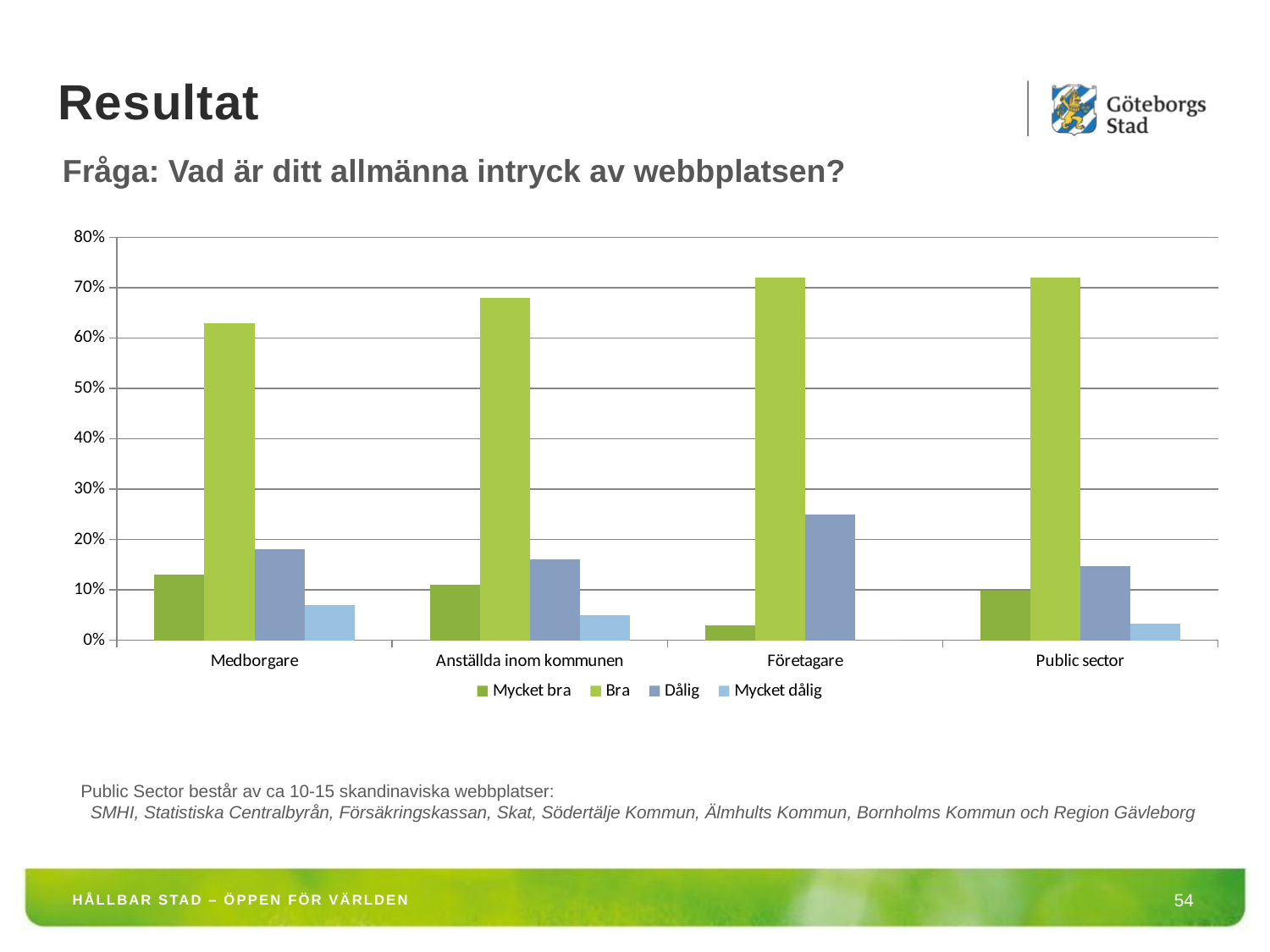
Is the value for Dålig in the Företagare category greater or less than 20%? greater Is the value for Bra in the Anställda inom kommunen category greater or less than 60%? greater Is the value for Bra in the Medborgare category greater or less than 60%? greater What are the four series listed in the chart's legend? Mycket bra, Bra, Dålig, Mycket dålig What kind of chart is shown on the slide? bar chart How many series does the chart's legend list? 4 How many categories are shown on the x axis of the chart? 4 Which category has the lowest value for Mycket bra? Företagare Which category has the highest value for Dålig? Företagare In the Medborgare category, which is larger: the value for Bra or the value for Dålig? Bra